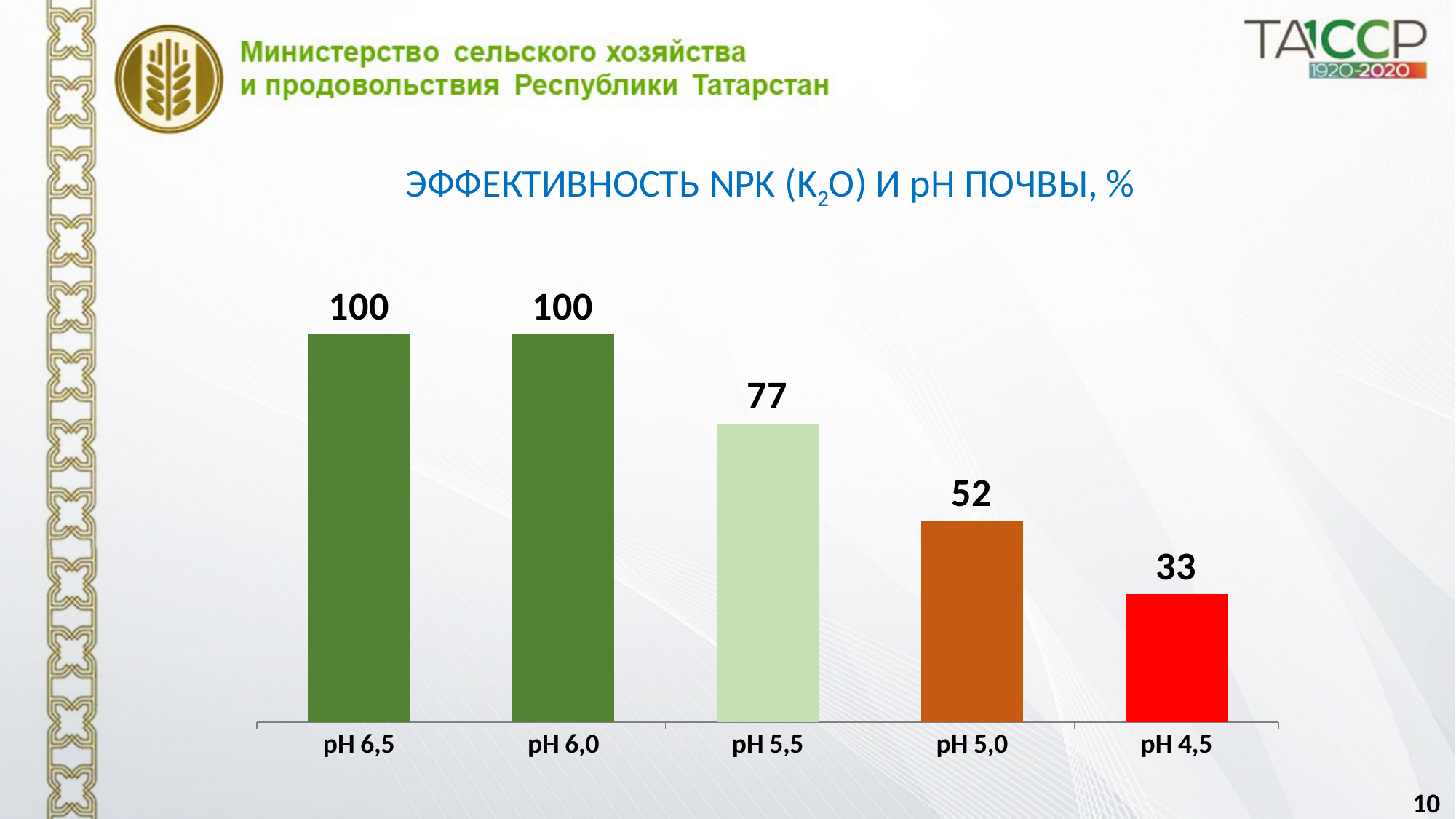
What is the value for pH 6,0? 100 What is the difference between the values for pH 5,5 and pH 5,0? 25 Do the values rise or fall from left to right along the x axis? fall What is the value for pH 4,5? 33 What is the value for pH 5,5? 77 Which category has the lowest value? pH 4,5 Which is larger, the value for pH 5,0 or the value for pH 4,5? pH 5,0 What is the difference between the values for pH 6,5 and pH 4,5? 67 What kind of chart is shown on the slide? bar chart How many categories are shown on the x axis? 5 What colour is the bar for pH 4,5? red What is the value for pH 5,0? 52